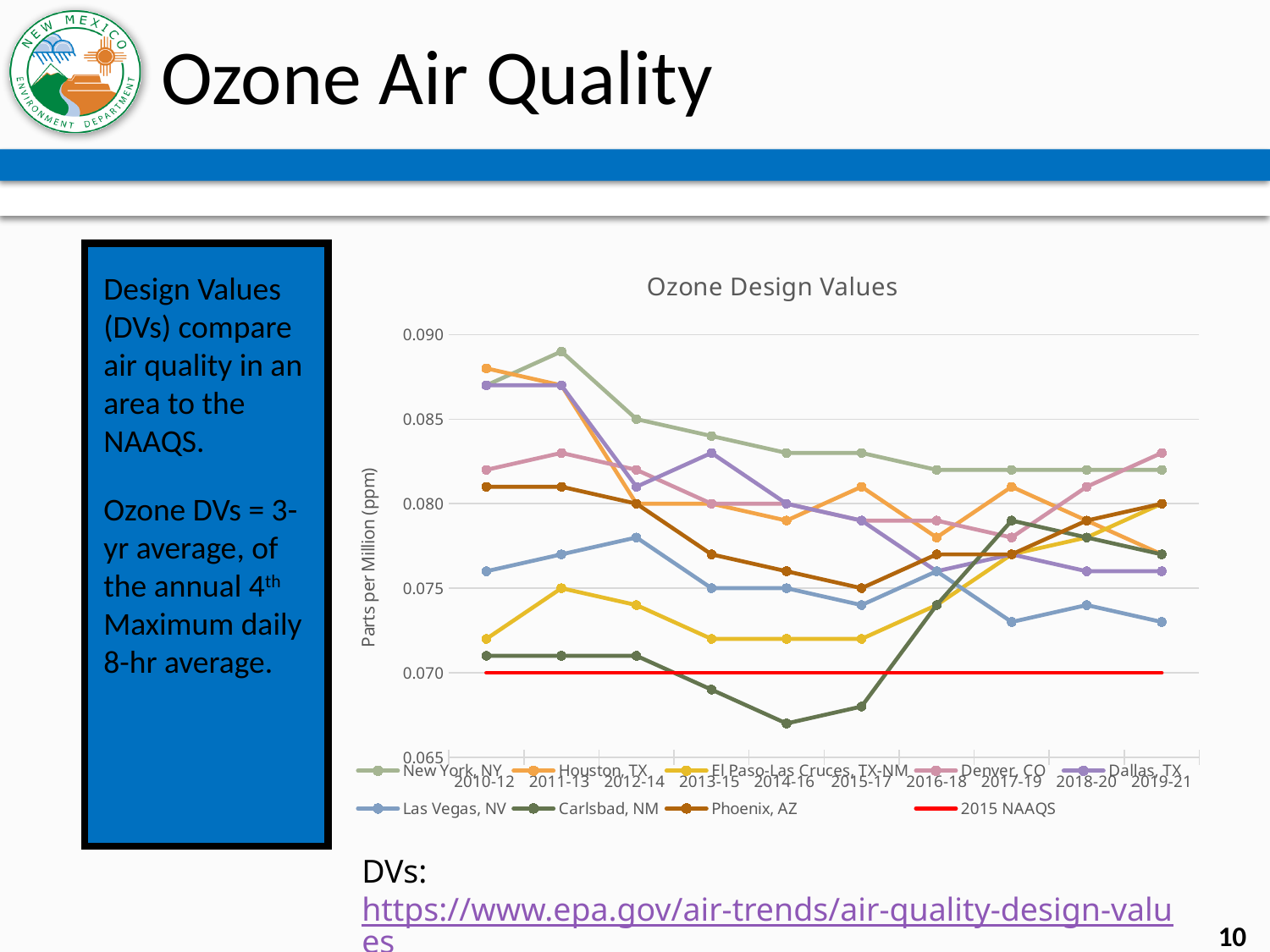
Is the value for New York, NY in 2011-13 greater or less than 0.085? greater How many time periods are shown along the x-axis? 10 Which city has the highest value in 2011-13? New York, NY What is the title of the chart? Ozone Design Values Is the value for Las Vegas, NV in 2017-19 greater or less than 0.075? less What kind of chart is shown on the slide? line chart At what value does the 2015 NAAQS line sit? 0.070 Is the value for Carlsbad, NM in 2014-16 greater or less than 0.070? less What is the label on the y-axis of the chart? Parts per Million (ppm) How many series does the chart's legend list? 9 Which city has the lowest value in 2014-16? Carlsbad, NM In 2015-17, which is higher: New York, NY or Las Vegas, NV? New York, NY